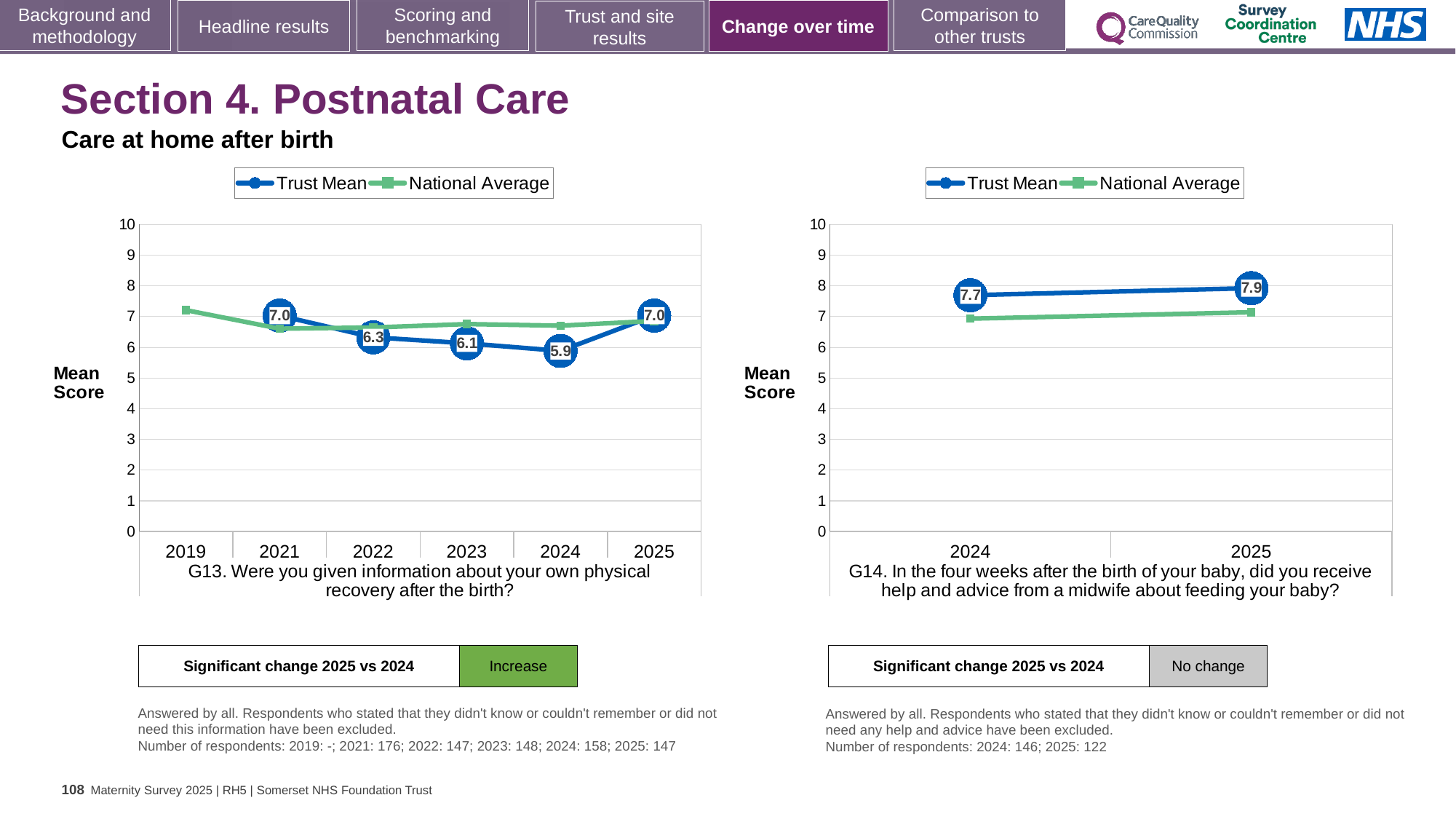
In the G13 chart on the left, is the National Average for 2019 greater or less than 6? greater What kind of chart is the G14 chart on the right? Line chart How many series does the legend of the G14 chart on the right list? 2 In the G13 chart on the left, what is the Trust Mean for 2025? 7.0 In the G13 chart on the left, which is larger: the Trust Mean for 2022 or the Trust Mean for 2024? 2022 In the G13 chart on the left, what is the difference between the Trust Mean for 2025 and the Trust Mean for 2024? 1.1 In the G13 chart on the left, which year has the lowest Trust Mean? 2024 In the G14 chart on the right, what is the difference between the Trust Mean for 2025 and for 2024? 0.2 How many years are shown on the x axis of the G13 chart on the left? 6 In the G13 chart on the left, what is the Trust Mean for 2023? 6.1 In the G14 chart on the right, what is the Trust Mean for 2024? 7.7 In the G14 chart on the right, does the Trust Mean rise or fall from 2024 to 2025? Rise